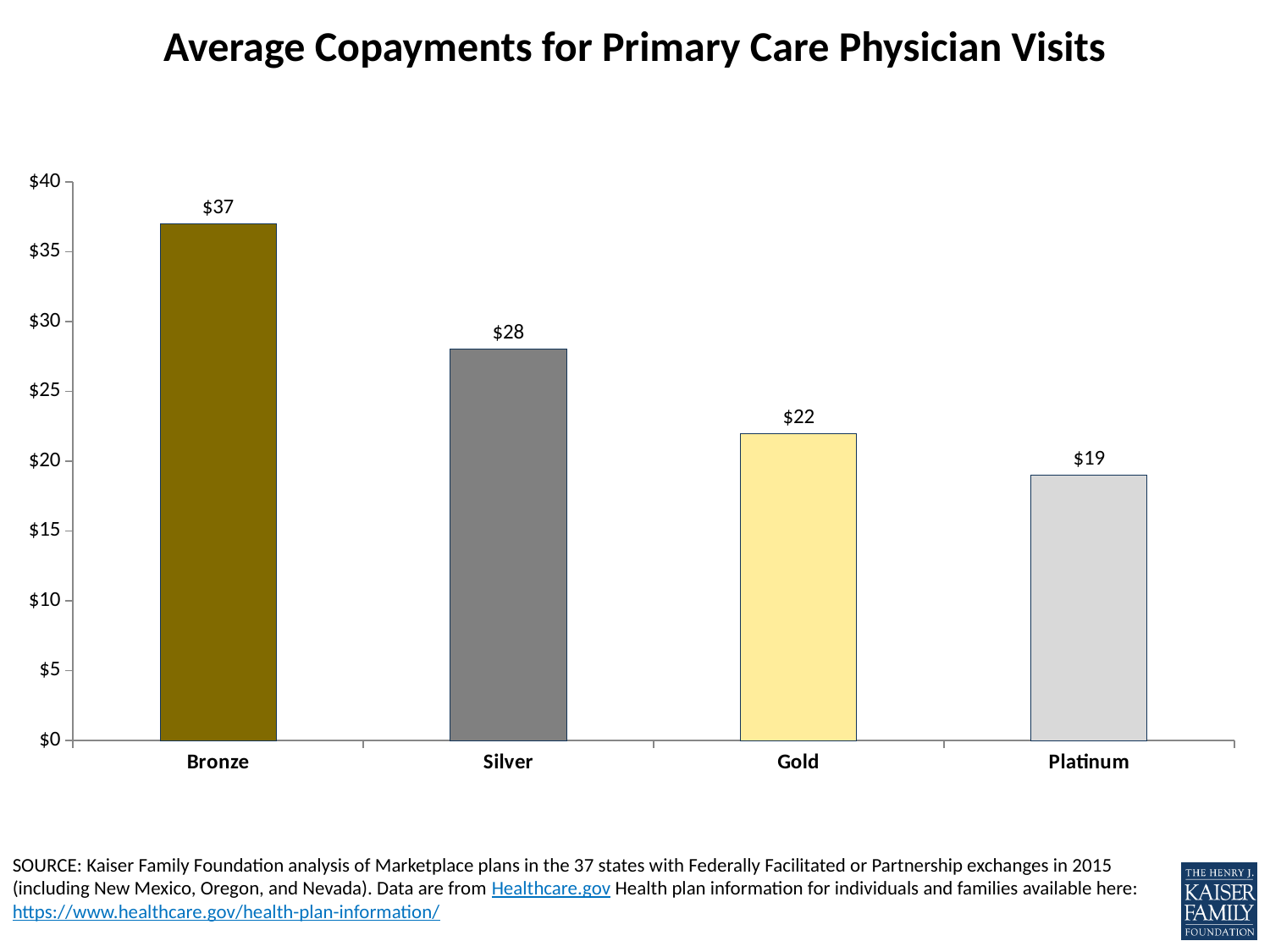
What is the average copayment for a primary care physician visit under Bronze plans? $37 What kind of chart is shown on the slide? Bar chart Is the average copayment for Silver plans greater or less than $25? greater Which plan type has the highest average copayment? Bronze What is the average copayment for Gold plans? $22 How many plan types are shown on the chart? 4 Which has a larger average copayment, Silver or Gold? Silver Which plan type has the lowest average copayment? Platinum What is the average copayment for Platinum plans? $19 How much higher is the average copayment for Bronze plans than for Silver plans? $9 What is the difference between the Gold and Platinum average copayments? $3 Do the average copayments rise or fall moving from Bronze to Platinum? Fall